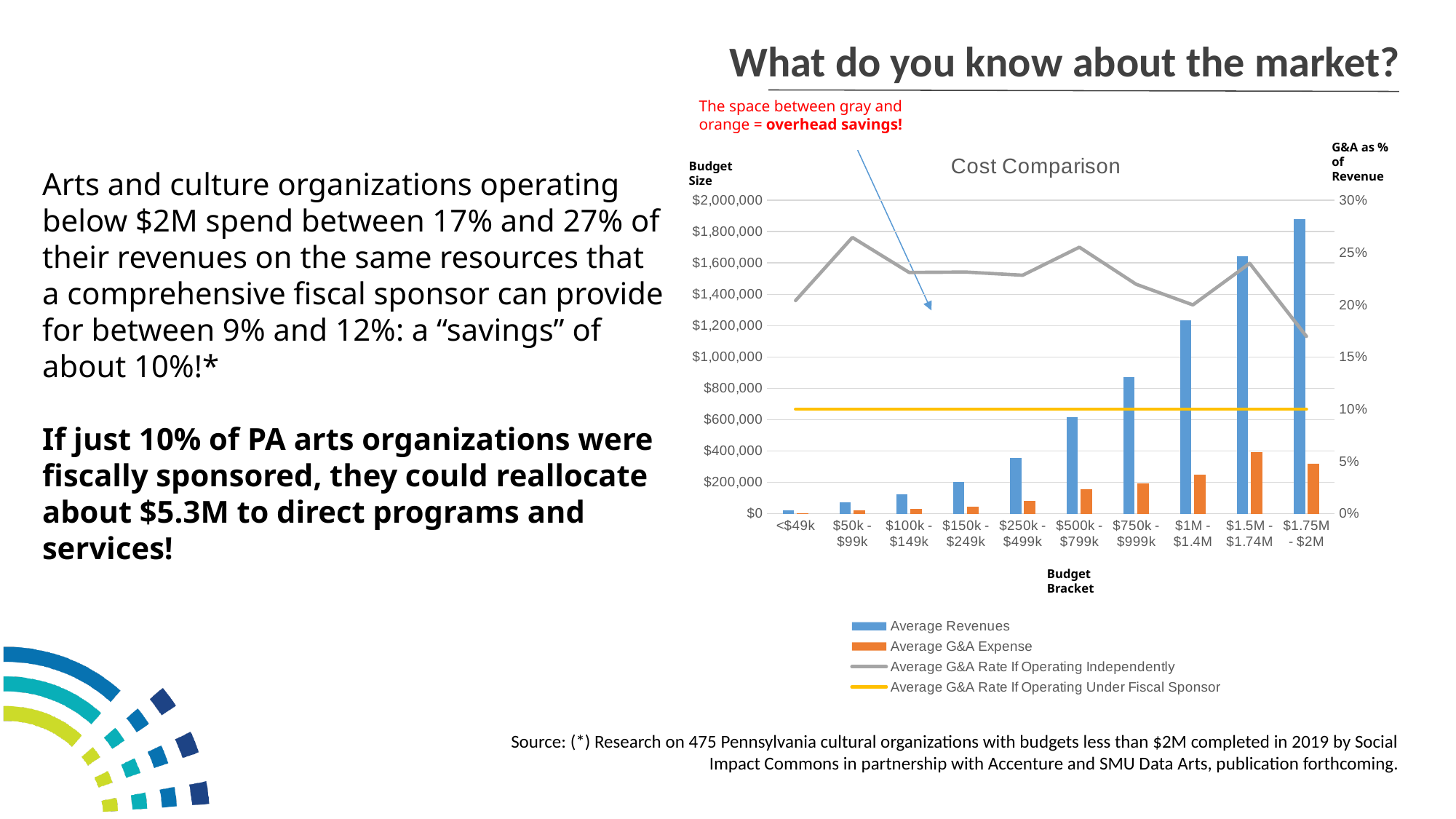
What type of chart is the Cost Comparison chart? A combination bar and line chart Is the Average Revenues value for the $1.75M - $2M bracket greater or less than $1,800,000? greater Is the Average Revenues value for the $1M - $1.4M bracket greater or less than $1,000,000? greater How many budget brackets are shown on the x axis of the Cost Comparison chart? 10 For the $500k - $799k bracket, which is larger: Average Revenues or Average G&A Expense? Average Revenues How many series does the legend of the Cost Comparison chart list? 4 Which budget bracket has the lowest Average G&A Rate If Operating Independently? $1.75M - $2M Which colour represents Average G&A Rate If Operating Under Fiscal Sponsor in the Cost Comparison chart? Yellow Which budget bracket has the lowest Average Revenues? <$49k Which budget bracket has the highest Average Revenues? $1.75M - $2M Do Average Revenues rise or fall as the budget bracket increases along the x axis? rise